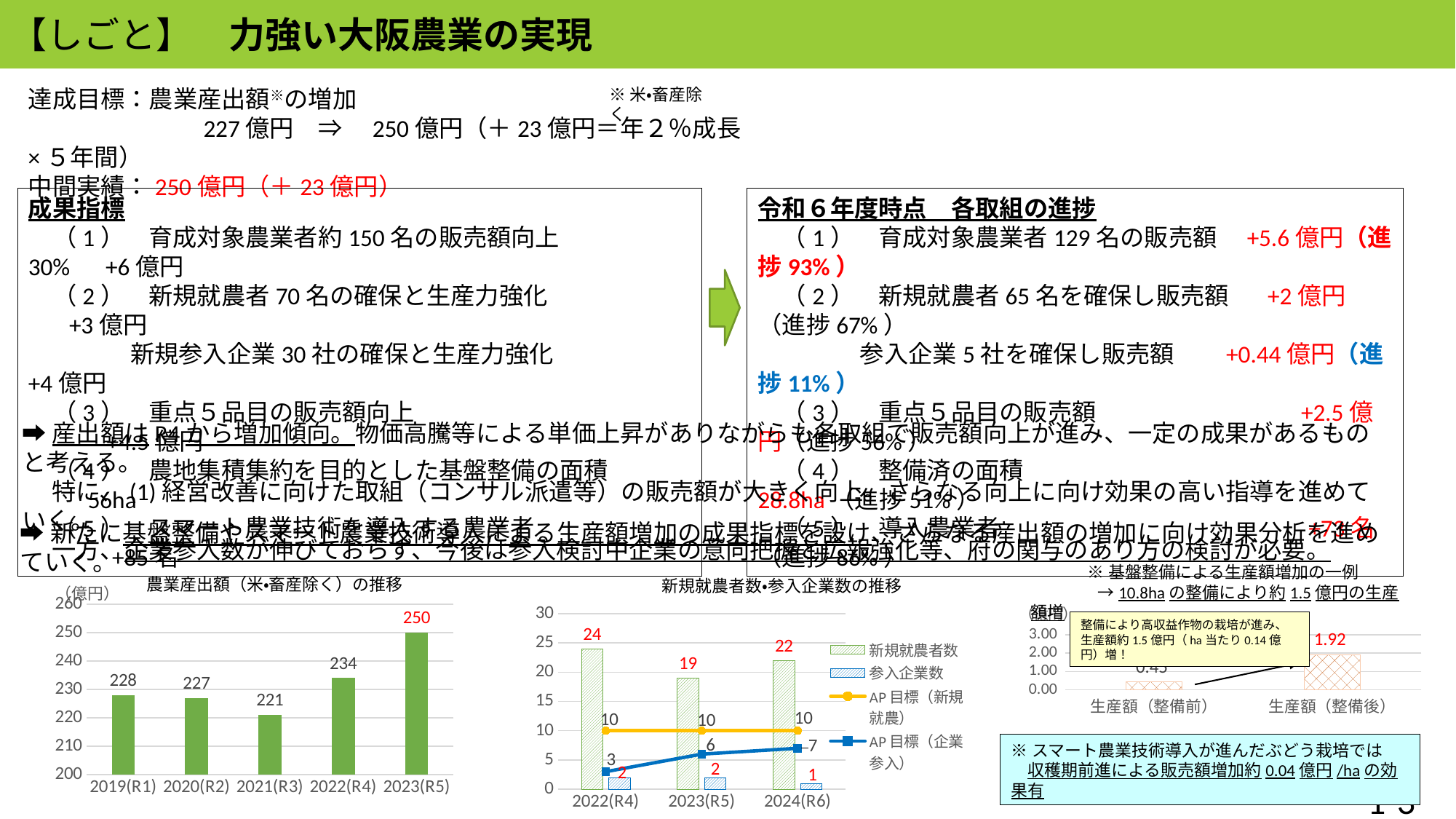
In the chart titled 新規就農者数・参入企業数の推移, what is the value of AP目標（企業参入） for 2023(R5)? 6 In the chart titled 農業産出額（米・畜産除く）の推移, which year has the highest value? 2023(R5) In the chart titled 農業産出額（米・畜産除く）の推移, what is the value for 2023(R5)? 250 What kind of chart is the one titled 農業産出額（米・畜産除く）の推移? bar chart In the chart titled 農業産出額（米・畜産除く）の推移, how many years are plotted? 5 In the chart titled 農業産出額（米・畜産除く）の推移, what is the difference between the values for 2023(R5) and 2022(R4)? 16 In the chart at the bottom right, what is the value for 生産額（整備後）? 1.92 In the chart titled 農業産出額（米・畜産除く）の推移, which year has the lowest value? 2021(R3) In the chart titled 農業産出額（米・畜産除く）の推移, what is the value for 2021(R3)? 221 In the chart titled 新規就農者数・参入企業数の推移, how many series does the legend list? 4 In the chart titled 新規就農者数・参入企業数の推移, what is the value of 参入企業数 for 2024(R6)? 1 In the chart titled 新規就農者数・参入企業数の推移, what is the value of 新規就農者数 for 2023(R5)? 19